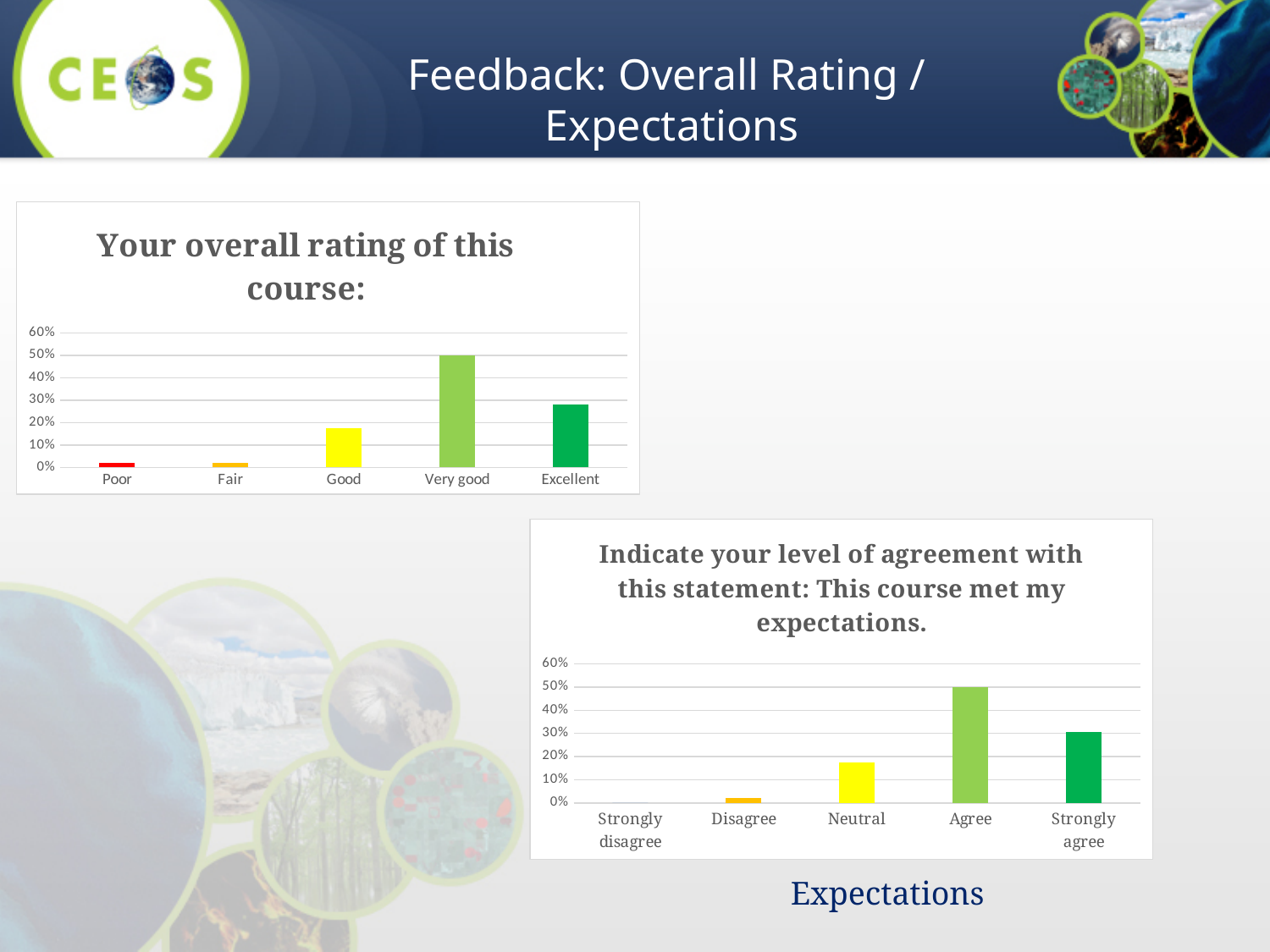
What kind of chart is the chart titled "Your overall rating of this course:"? bar chart In the chart titled "Indicate your level of agreement with this statement: This course met my expectations.", which is larger, the value for Agree or the value for Strongly agree? Agree In the chart titled "Indicate your level of agreement with this statement: This course met my expectations.", which category has the highest value? Agree In the chart titled "Indicate your level of agreement with this statement: This course met my expectations.", which category has the lowest value? Strongly disagree In the chart titled "Your overall rating of this course:", how many categories are shown on the x axis? 5 In the chart titled "Indicate your level of agreement with this statement: This course met my expectations.", is the value for Strongly agree greater or less than 20%? greater In the chart titled "Indicate your level of agreement with this statement: This course met my expectations.", is the value for Neutral greater or less than 30%? less In the chart titled "Your overall rating of this course:", is the value for Very good greater or less than 40%? greater In the chart titled "Your overall rating of this course:", which category has the highest value? Very good In the chart titled "Your overall rating of this course:", which is larger, the value for Excellent or the value for Good? Excellent In the chart titled "Indicate your level of agreement with this statement: This course met my expectations.", how many categories are shown on the x axis? 5